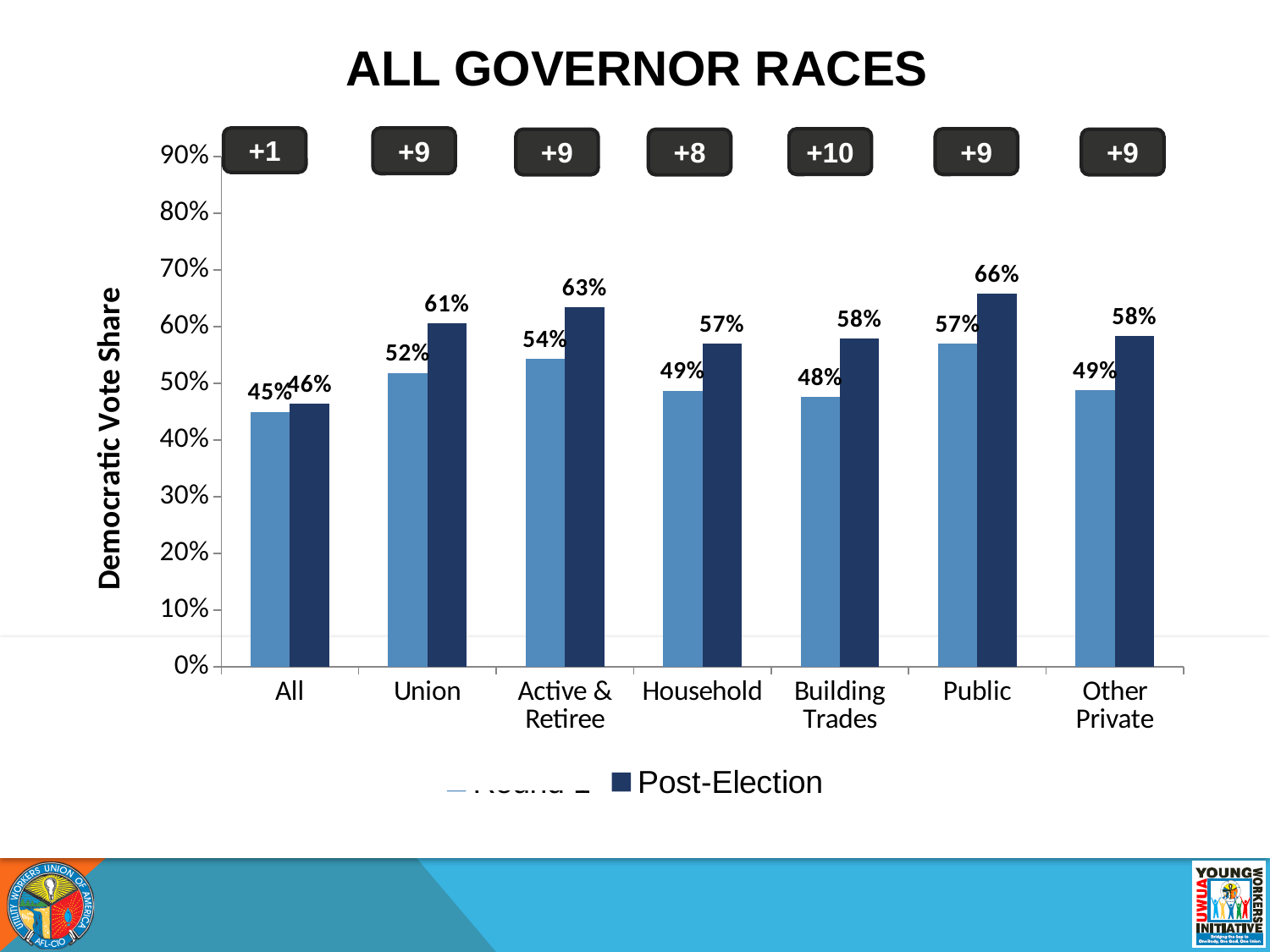
Is the Post-Election value for Household greater or less than 50%? greater What is the difference between the Post-Election values for Public and All? 20 percentage points What is the value of the lighter blue bar for Active & Retiree? 54% How many categories are shown on the x axis? 7 What is the Post-Election value for Public? 66% Which category has the lowest Post-Election value? All Which has a larger Post-Election value, Union or Household? Union What number is shown in the dark box above the Building Trades group? +10 What kind of chart is shown on the slide? bar chart How many series does the legend list? 2 Which category has the highest Post-Election value? Public What is the Post-Election value for Union? 61%